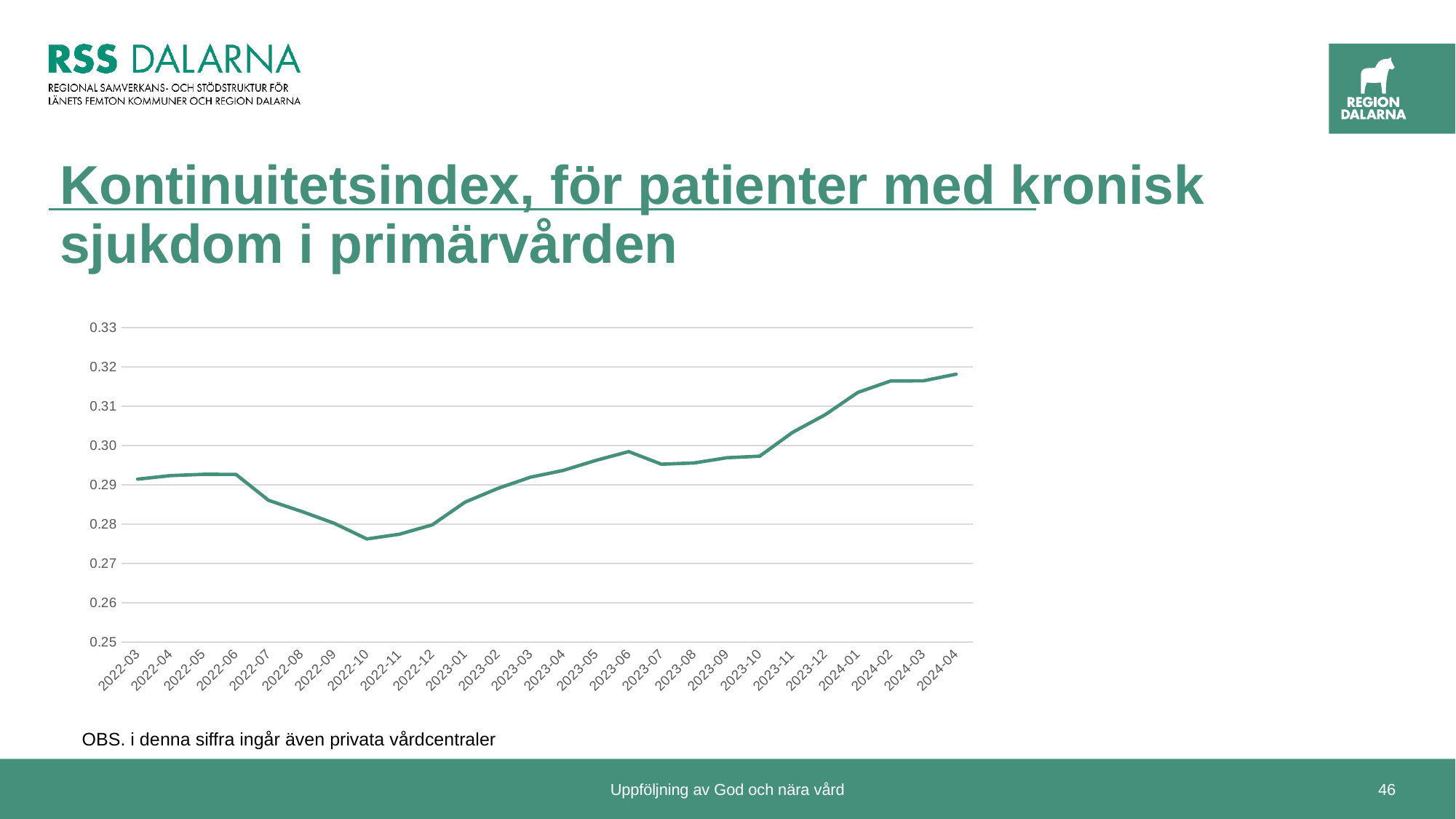
Is the value for 2022-10 greater or less than 0.28? less Which is larger, the value for 2022-06 or the value for 2022-10? 2022-06 Which month has the highest continuity index value? 2024-04 What is the first month shown on the x axis? 2022-03 Is the value for 2024-01 greater or less than 0.31? greater What kind of chart is shown on the slide? line chart Does the continuity index rise or fall between 2022-06 and 2022-10? fall Is the value for 2023-01 greater or less than 0.29? less Which month has the lowest continuity index value? 2022-10 Which is larger, the value for 2023-06 or the value for 2023-07? 2023-06 How many monthly data points are plotted on the x axis? 26